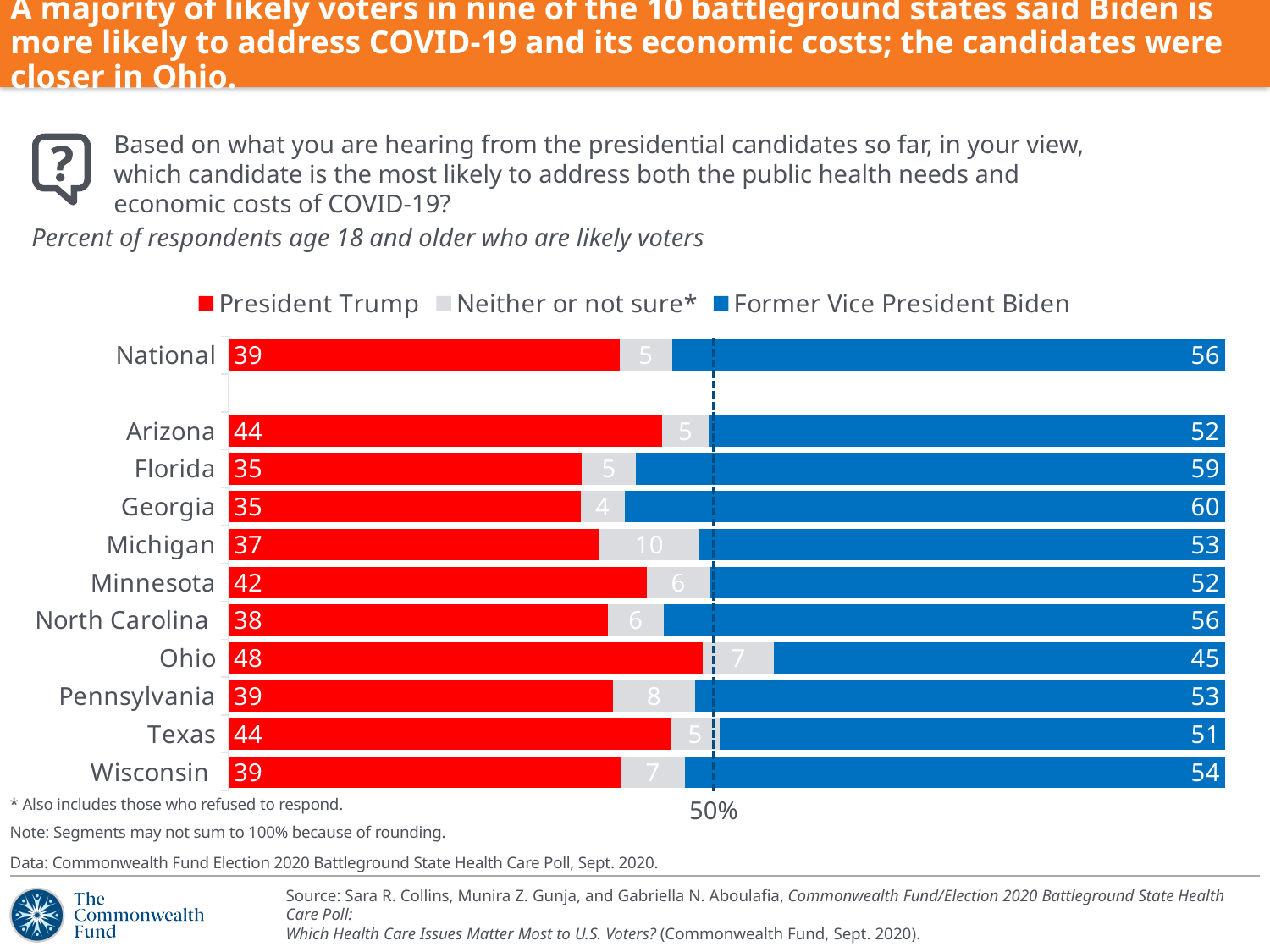
What is the total of the three segments for the Ohio bar? 100 Which state has the lowest value for Former Vice President Biden? Ohio What percentage of likely voters in Georgia said Former Vice President Biden is most likely to address COVID-19? 60 Which state has the highest value for Former Vice President Biden? Georgia How many series does the legend list? 3 What kind of chart is shown on the slide? Stacked bar chart How many categories (rows) are shown in the chart, including National? 11 What is the value for President Trump in Ohio? 48 Which state has the highest value for President Trump? Ohio What is the difference between the Biden and Trump values for Florida? 24 What is the 'Neither or not sure*' value for Michigan? 10 Is the Biden value larger in Texas or in Wisconsin? Wisconsin